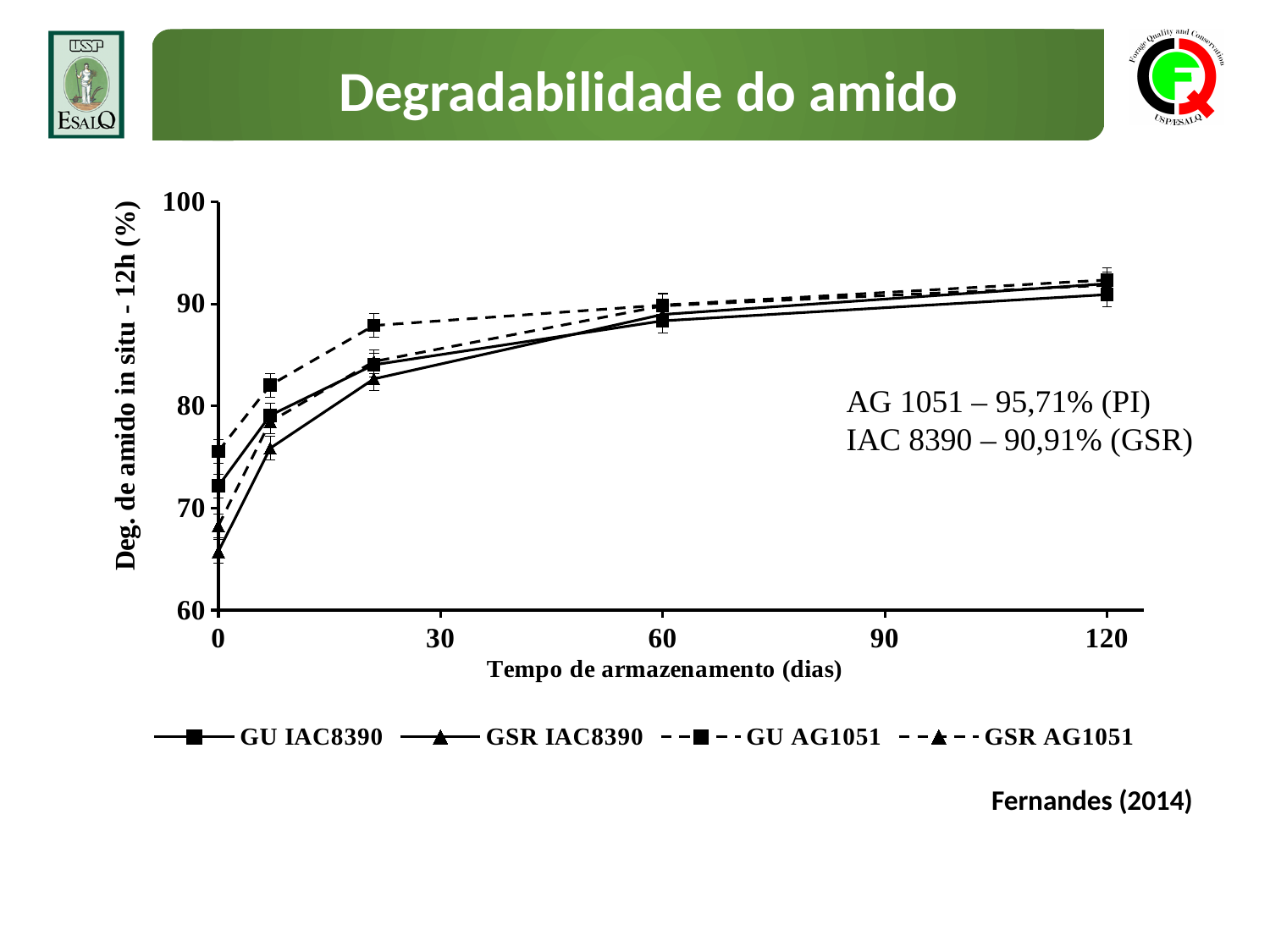
Is the value for GU AG1051 at 0 days greater or less than 70? greater What kind of chart is shown on the slide? line chart Do the values for GU IAC8390 rise or fall as storage time increases from 0 to 120 days? rise Which series has the highest value at 0 days of storage? GU AG1051 What is the label of the x axis? Tempo de armazenamento (dias) Is the value for GU AG1051 at 120 days greater or less than 90? greater How many time points are plotted for each series? 5 How many series does the legend list? 4 Is the value for GSR IAC8390 at 0 days greater or less than 70? less What is the title of the chart on the slide? Degradabilidade do amido Which series has the lowest value at 0 days of storage? GSR IAC8390 At 0 days of storage, which is larger: the value for GU AG1051 or the value for GSR IAC8390? GU AG1051